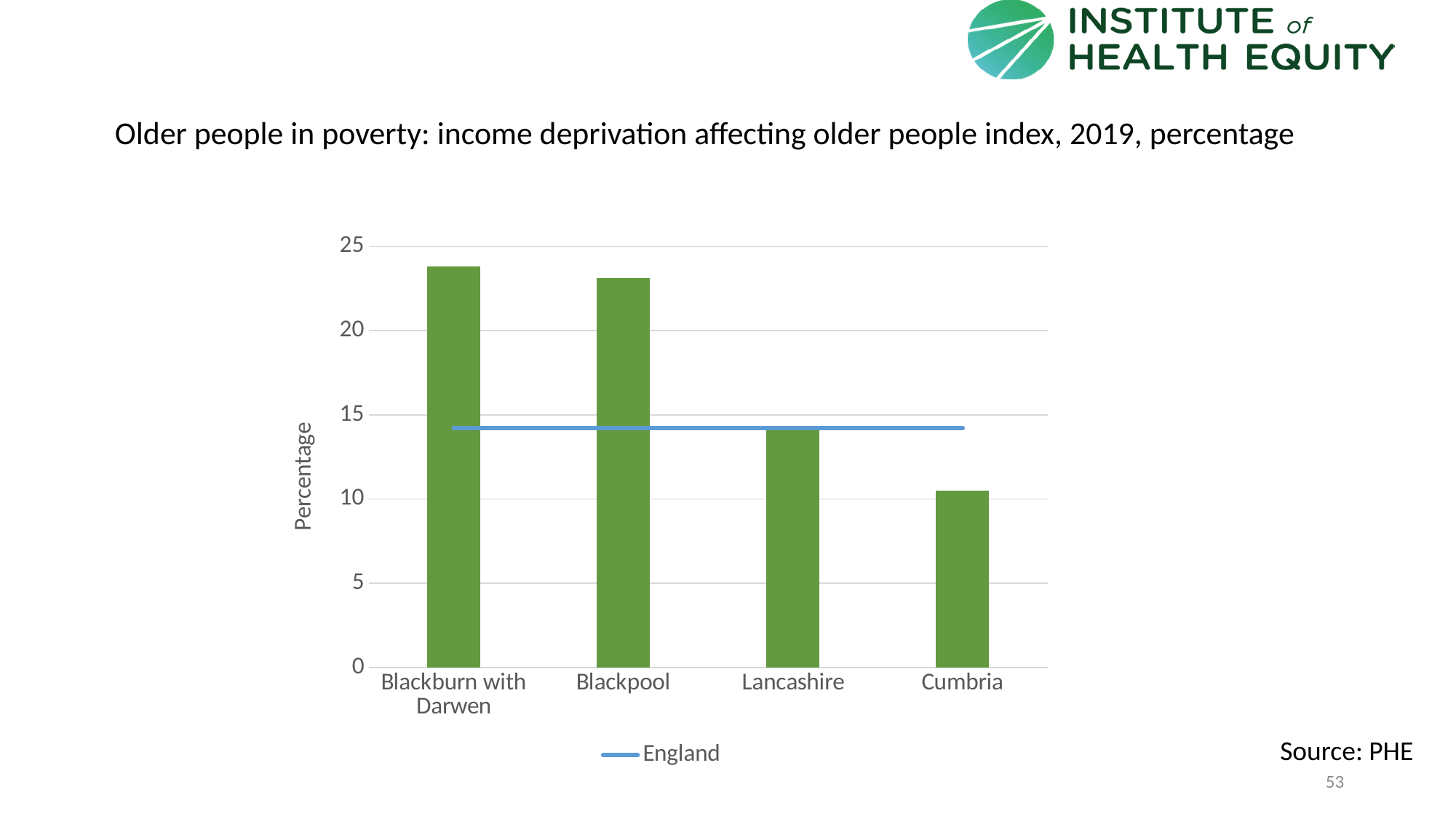
Do the bar values rise or fall moving from left to right along the x axis? Fall Which area has the highest percentage of older people in poverty? Blackburn with Darwen How many series does the chart's legend list? 1 Is the value for Blackburn with Darwen greater or less than 20? greater How many local areas are shown on the x axis of the chart? 4 Which is larger, the value for Blackpool or the value for Lancashire? Blackpool Is the value for Cumbria greater or less than 15? less What does the horizontal blue line in the chart represent, according to the legend? England Is the value for Blackpool greater or less than 20? greater What kind of chart is shown on the slide? Combination bar and line chart Which area has the lowest percentage of older people in poverty? Cumbria